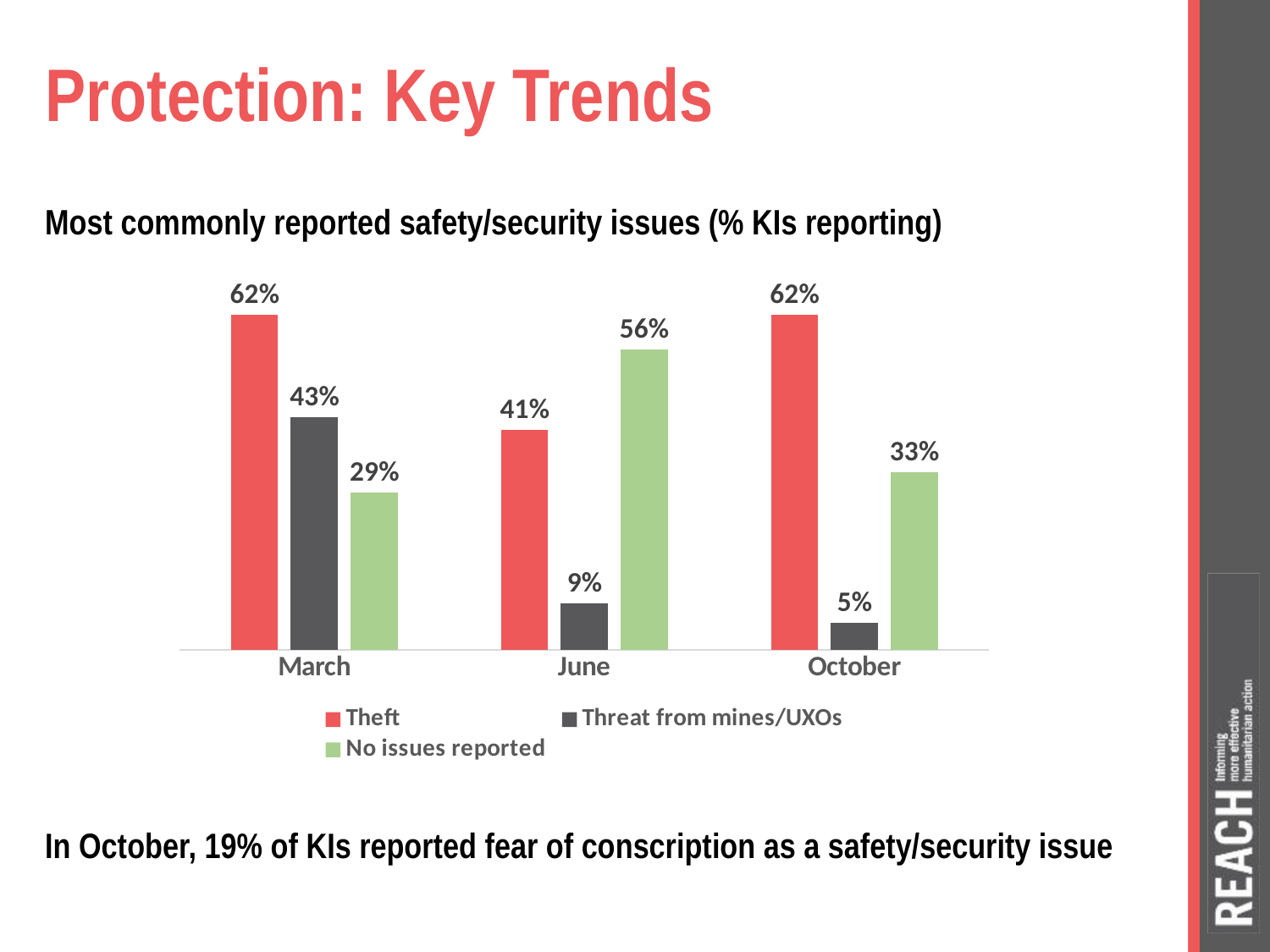
In June, which was larger: theft or no issues reported? No issues reported Does the 'Threat from mines/UXOs' series rise or fall from March to October? Fall What is the difference between the theft values for March and June? 21 percentage points What percentage of KIs reported no issues in October? 33% What kind of chart is shown on the slide? Bar chart What is the value for 'Threat from mines/UXOs' in June? 9% In which month was 'Threat from mines/UXOs' lowest? October In which month was 'No issues reported' highest? June How many months are shown on the x axis? 3 What percentage of KIs reported theft in March? 62% How many series does the legend list? 3 Which colour represents 'Theft' in the chart? Red